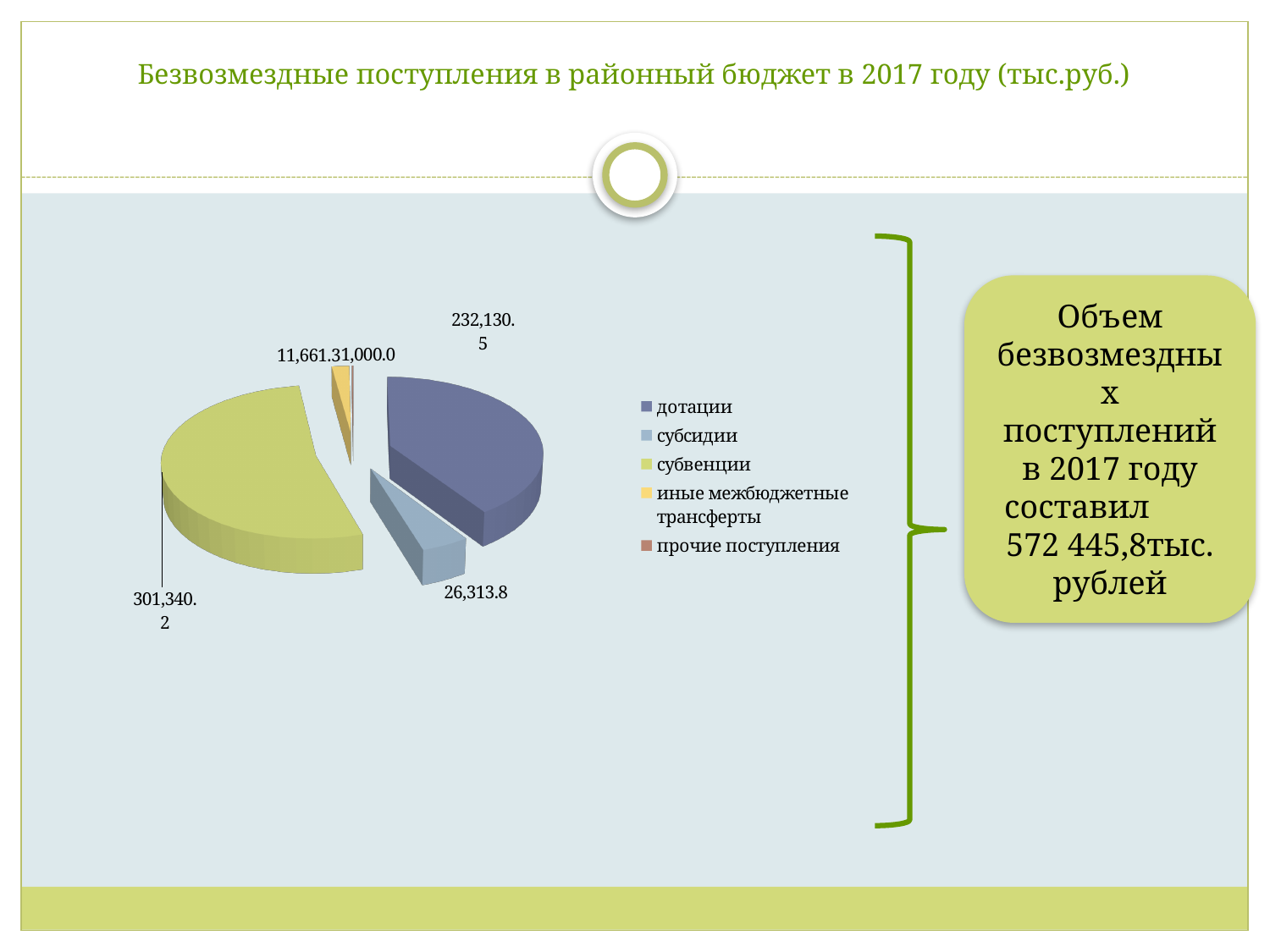
Which is larger, дотации or субсидии? дотации According to the text box, what was the total volume of безвозмездные поступления in 2017? 572 445,8 тыс. рублей What is the difference between дотации and субсидии? 205,816.7 What is the value for дотации in the pie chart? 232,130.5 How many categories does the legend of the pie chart list? 5 What is the title of the slide containing the pie chart? Безвозмездные поступления в районный бюджет в 2017 году (тыс.руб.) What is the value for субвенции in the pie chart? 301,340.2 Which category has the largest slice in the pie chart? субвенции What is the value for субсидии in the pie chart? 26,313.8 What kind of chart is shown on the slide? pie chart What colour represents субвенции in the pie chart legend? green What is the difference between субвенции and дотации? 69,209.7